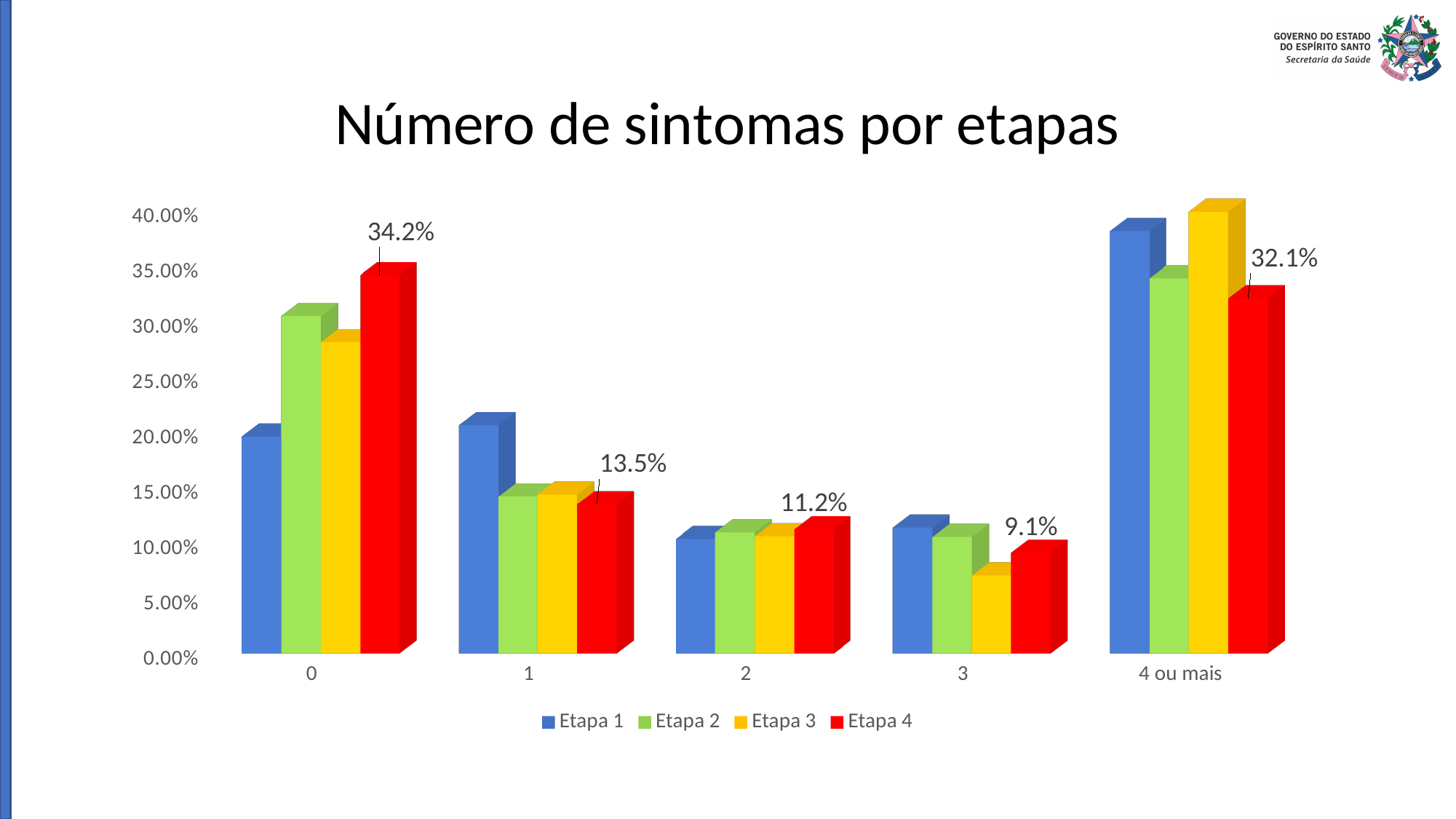
In which category does Etapa 4 have its highest value? 0 What is the value for Etapa 4 in the category '4 ou mais'? 32.1% What is the value for Etapa 4 in category 1? 13.5% In which category does Etapa 4 have its lowest value? 3 How many categories are shown on the x axis? 5 Is the value for Etapa 3 in category 3 greater or less than 10.00%? less Which is larger for Etapa 4: the value for category 1 or category 2? Category 1 What is the difference between the Etapa 4 values for category 0 and '4 ou mais'? 2.1 percentage points What is the value for Etapa 4 in category 3? 9.1% What is the value for Etapa 4 in category 0? 34.2% Is the value for Etapa 1 in the category '4 ou mais' greater or less than 35.00%? greater How many series does the legend list? 4